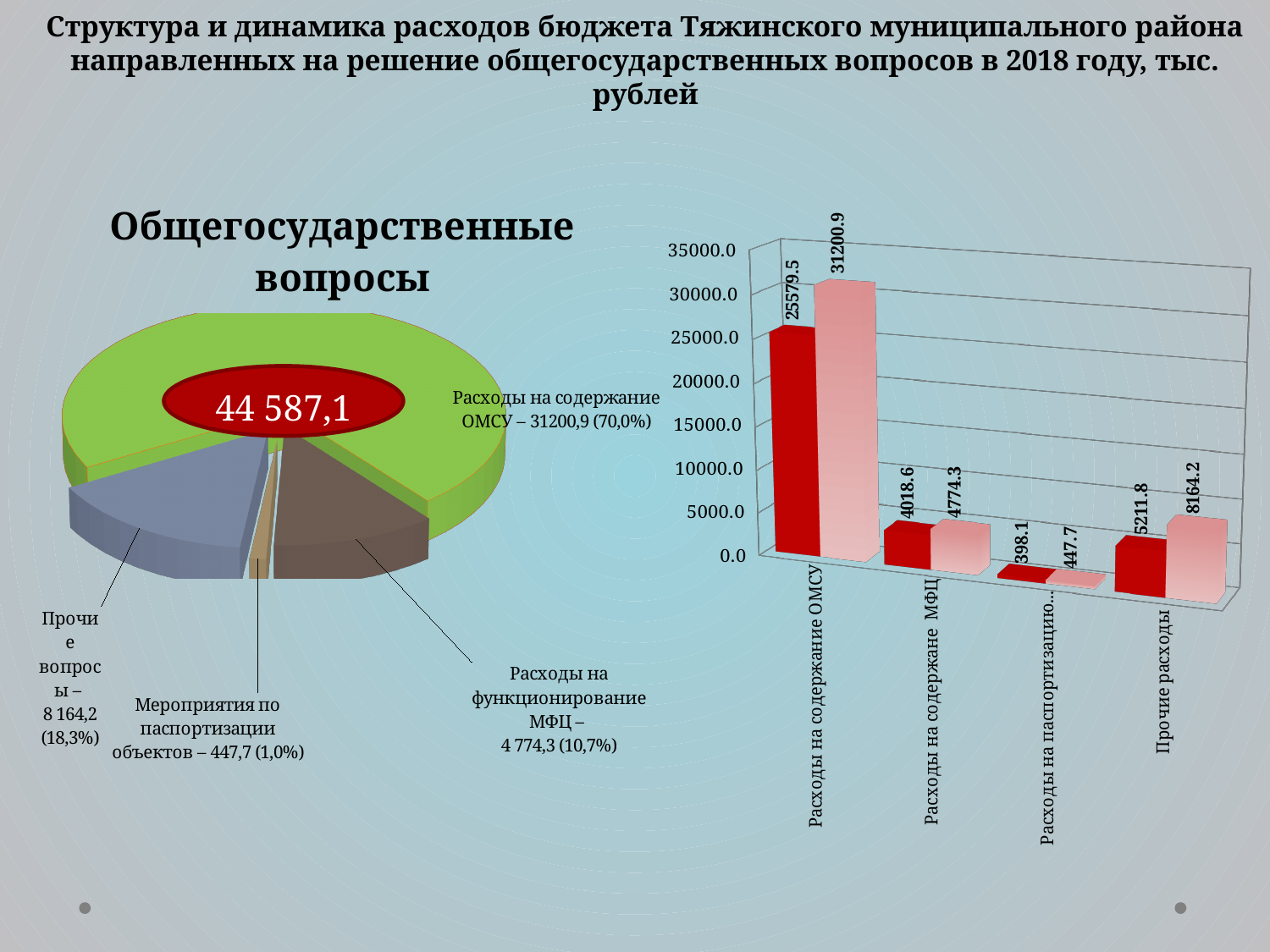
In the bar chart on the right, what is the value of the dark red bar for Расходы на содержание ОМСУ? 25579.5 In the bar chart on the right, what is the difference between the pink bar and the dark red bar for Прочие расходы? 2952.4 In the pie chart on the left, which slice is the smallest? Мероприятия по паспортизации объектов How many slices does the pie chart on the left have? 4 In the bar chart on the right, which dark red bar is larger: Расходы на содержане МФЦ or Прочие расходы? Прочие расходы In the pie chart on the left, what is the value for Расходы на функционирование МФЦ? 4 774,3 In the pie chart on the left, which slice is the largest? Расходы на содержание ОМСУ In the bar chart on the right, what is the value of the pink bar for Прочие расходы? 8164.2 What total value is shown in the centre of the pie chart on the left? 44 587,1 In the pie chart on the left, what share of the total is Расходы на содержание ОМСУ? 70,0% How many categories are shown on the x axis of the bar chart on the right? 4 What kind of chart is the chart on the right of the slide? bar chart